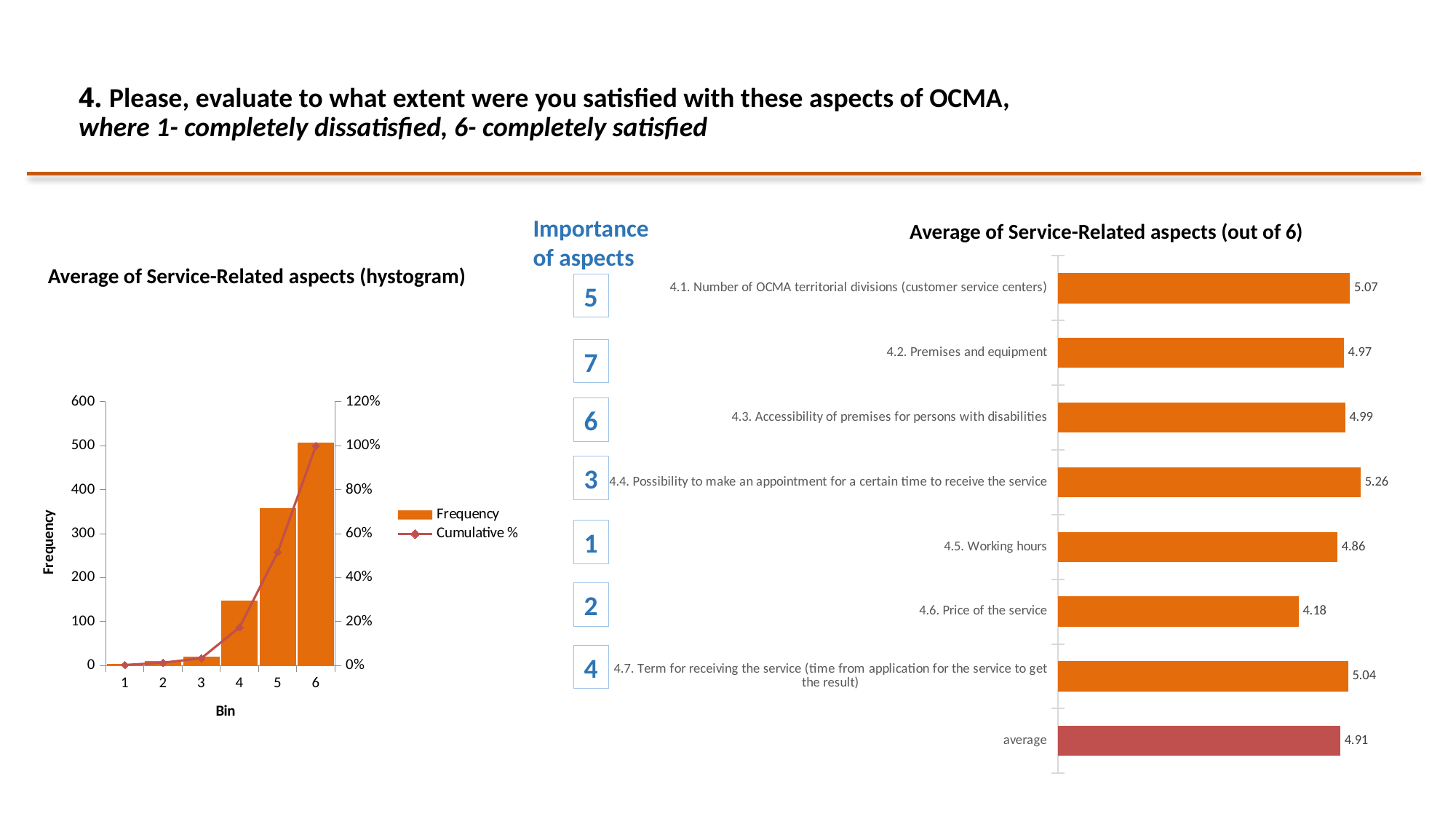
How many bars are shown in the 'Average of Service-Related aspects (out of 6)' chart? 8 How many series does the legend of the 'Average of Service-Related aspects (hystogram)' chart list? 2 In the 'Average of Service-Related aspects (out of 6)' chart, what is the value for 4.5. Working hours? 4.86 What kind of chart is the 'Average of Service-Related aspects (out of 6)' chart? bar chart In the 'Average of Service-Related aspects (out of 6)' chart, which aspect has the highest value? 4.4. Possibility to make an appointment for a certain time to receive the service In the 'Average of Service-Related aspects (out of 6)' chart, what is the value for 4.6. Price of the service? 4.18 In the 'Average of Service-Related aspects (out of 6)' chart, what is the value of the 'average' bar? 4.91 In the 'Average of Service-Related aspects (hystogram)' chart, is the Frequency value for bin 5 greater or less than 300? greater In the 'Average of Service-Related aspects (out of 6)' chart, which aspect has the lowest value? 4.6. Price of the service In the 'Average of Service-Related aspects (out of 6)' chart, which is larger: the value for 4.1 (number of territorial divisions) or 4.2 (premises and equipment)? 4.1. Number of OCMA territorial divisions (customer service centers) In the 'Average of Service-Related aspects (out of 6)' chart, what is the difference between the value for 4.4 (appointment) and 4.6 (price of the service)? 1.08 In the 'Average of Service-Related aspects (hystogram)' chart, does the Frequency rise or fall from bin 1 to bin 6? rise